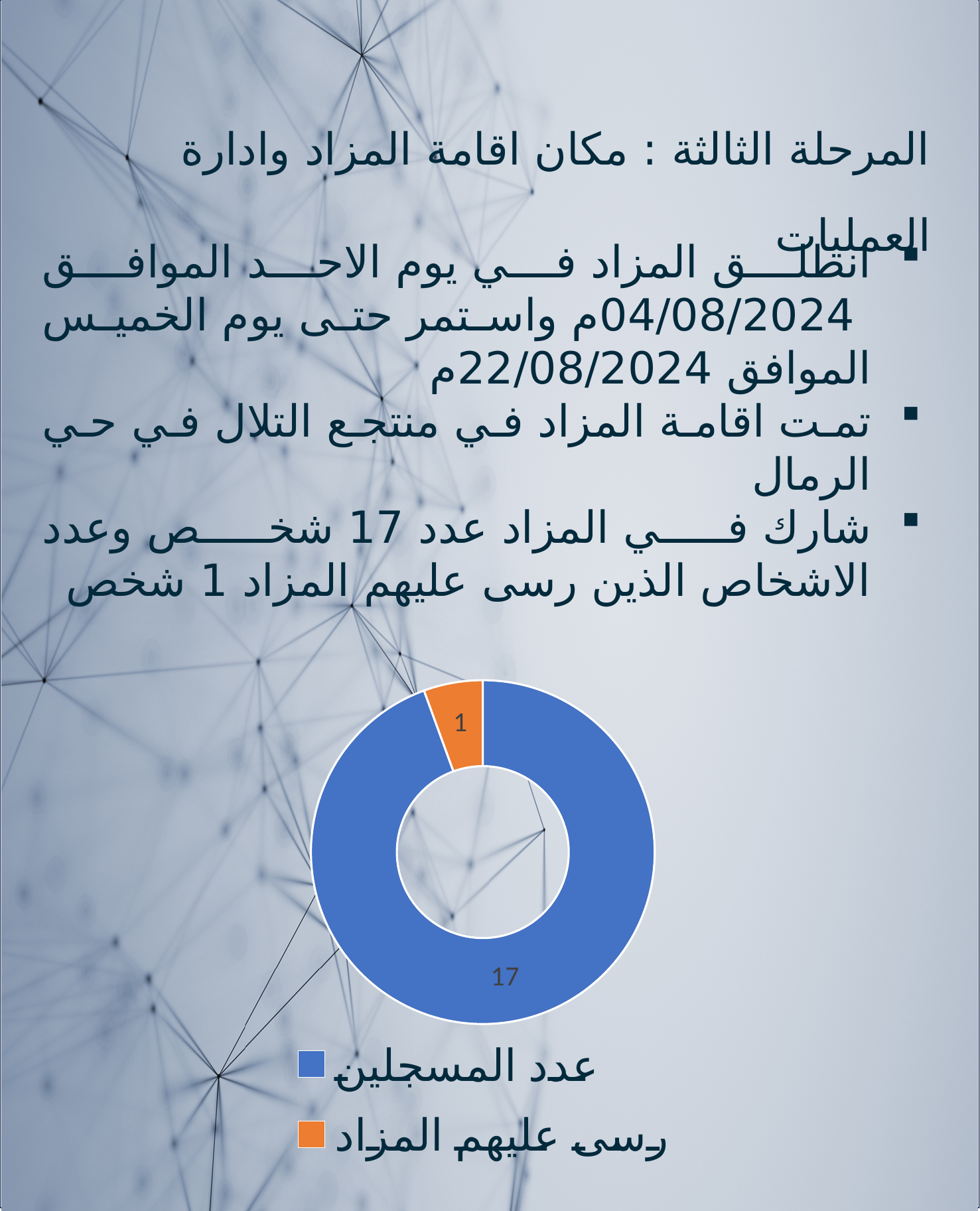
What type of chart is shown on the slide? Doughnut chart What is the value for عدد المسجلين in the doughnut chart? 17 What colour is the slice for عدد المسجلين? Blue What is the difference between the values for عدد المسجلين and رسى عليهم المزاد? 16 What colour is the slice for رسى عليهم المزاد? Orange What is the total of the two values shown in the doughnut chart? 18 Which category has the smallest slice in the doughnut chart? رسى عليهم المزاد Which is larger, the value for عدد المسجلين or the value for رسى عليهم المزاد? عدد المسجلين How many entries does the legend of the doughnut chart list? 2 What is the value for رسى عليهم المزاد in the doughnut chart? 1 How many slices does the doughnut chart have? 2 Which category has the largest slice in the doughnut chart? عدد المسجلين